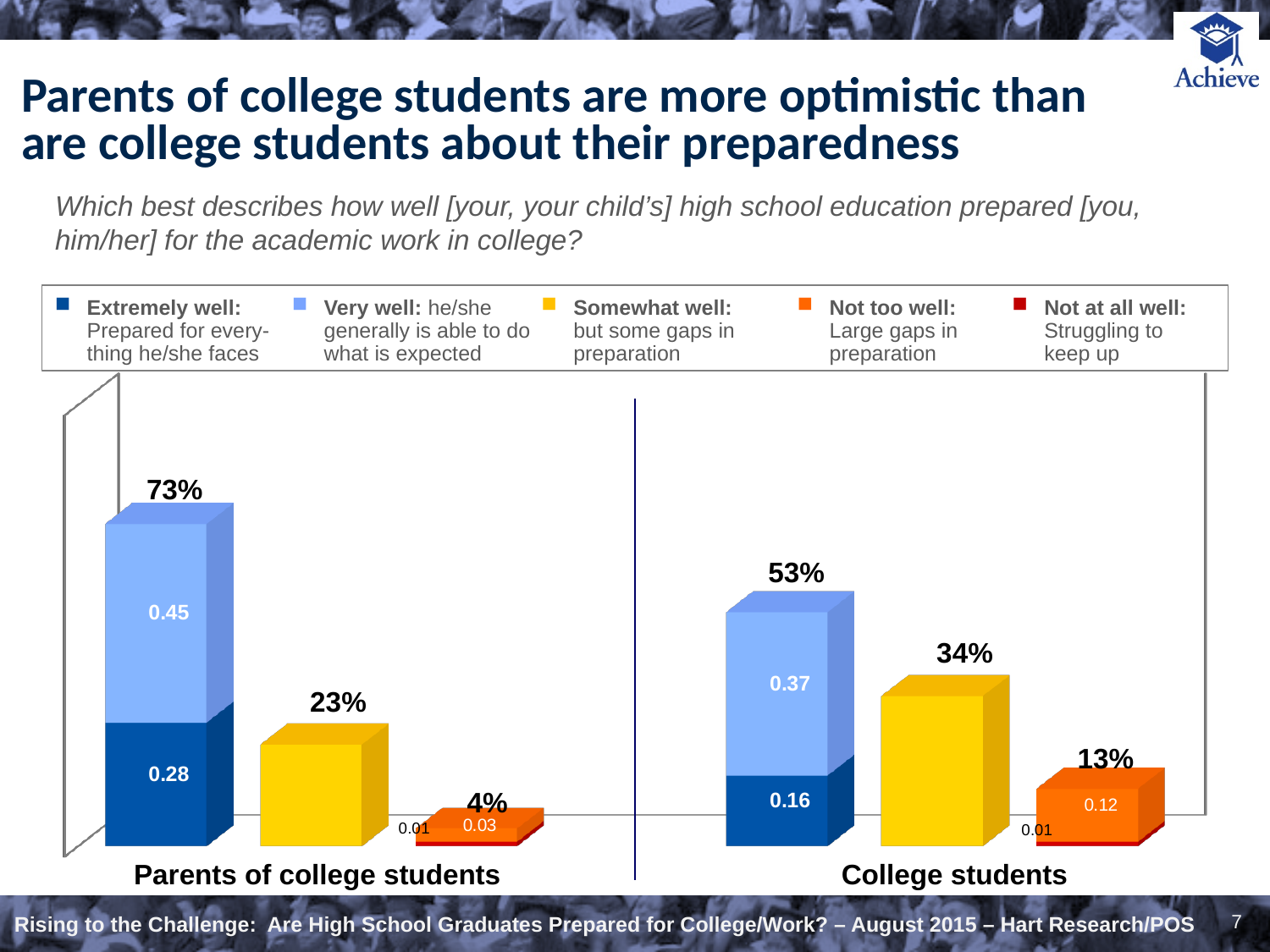
What is the combined 'Extremely well' plus 'Very well' total shown for Parents of college students? 73% What is the value of the 'Extremely well' segment for Parents of college students? 0.28 What is the combined 'Extremely well' plus 'Very well' total shown for College students? 53% What kind of chart is shown on the slide? bar chart What is the difference between the 'Extremely well' values for Parents of college students and College students? 0.12 What is the value of the 'Not too well' segment for College students? 0.12 What is the value of the 'Very well' segment for College students? 0.37 Which group has the larger combined 'Not too well' plus 'Not at all well' total, Parents of college students or College students? College students How many respondent groups are shown along the x axis? 2 What is the difference between the 'Somewhat well' percentage for College students and for Parents of college students? 11% What percentage of College students said 'Somewhat well'? 34% How many series does the legend list? 5